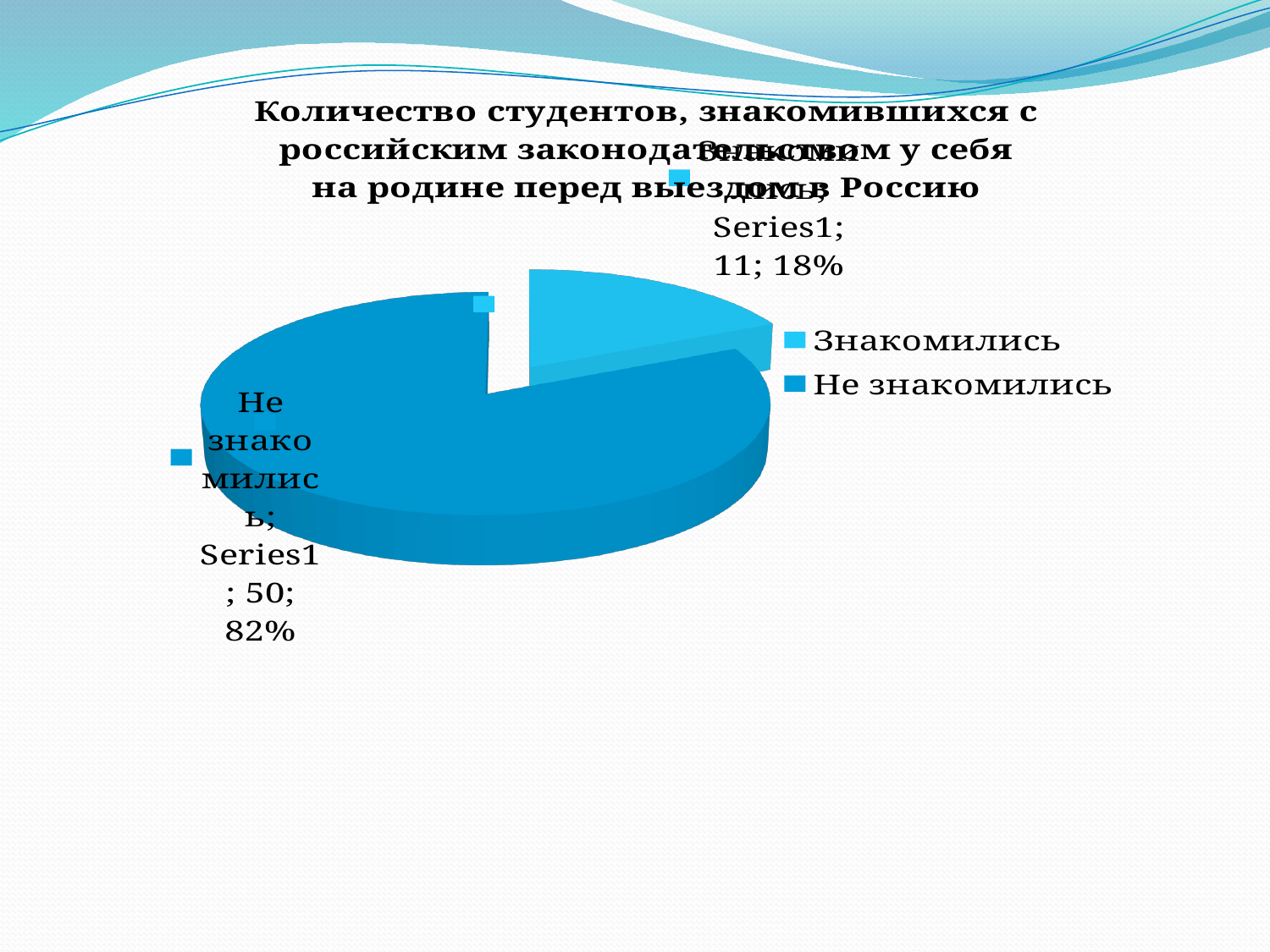
What is the total of the two slice values? 61 What kind of chart is shown on the slide? pie chart Which is larger, the value for "Знакомились" or for "Не знакомились"? Не знакомились What share of the pie does "Не знакомились" represent? 82% What is the value for "Не знакомились"? 50 Which category has the largest slice? Не знакомились What share of the pie does "Знакомились" represent? 18% How many slices does the pie chart have? 2 What is the difference between the values for "Не знакомились" and "Знакомились"? 39 Which category has the smallest slice? Знакомились How many entries does the legend list? 2 What is the value for "Знакомились"? 11